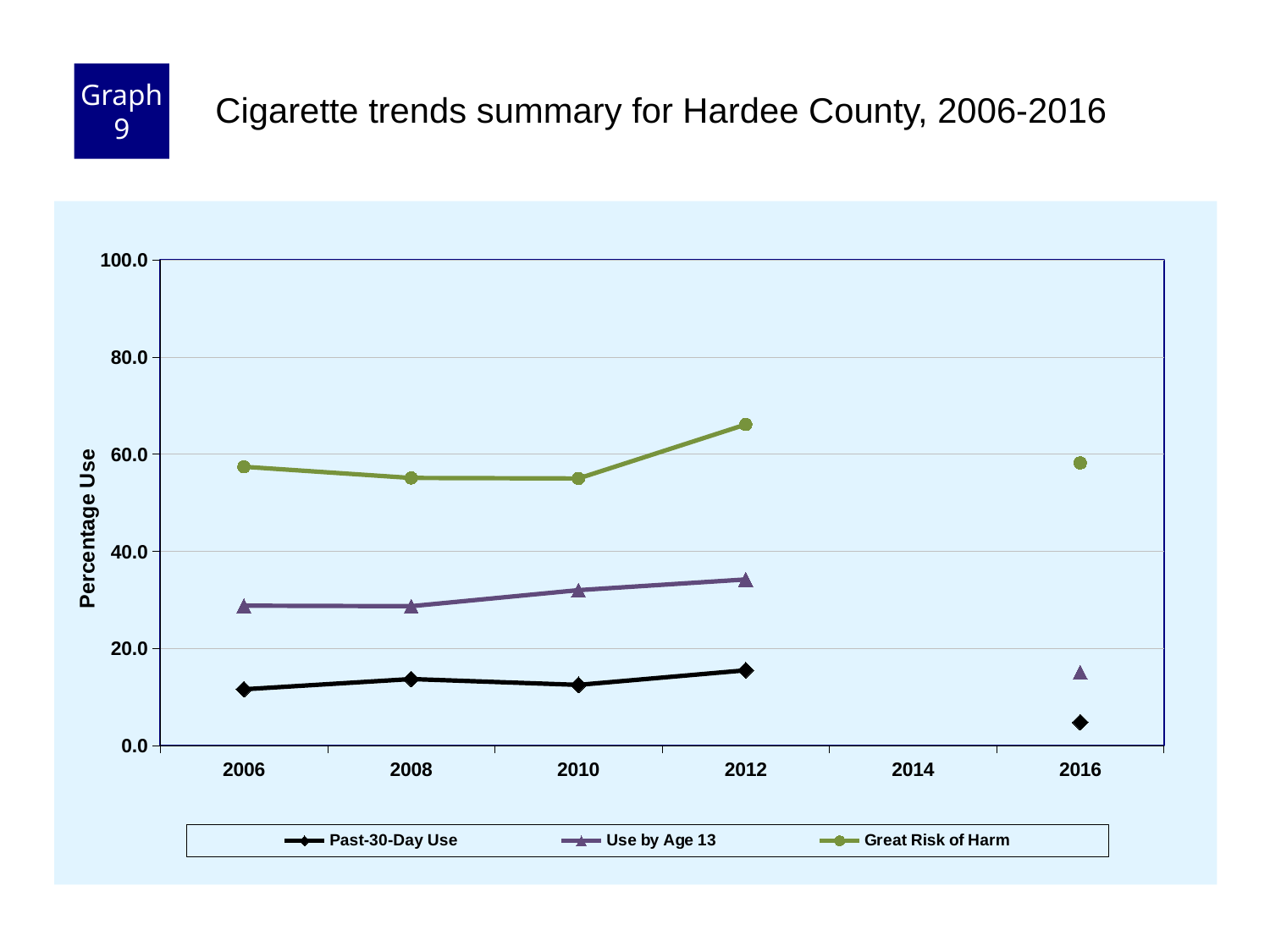
How many years are labeled on the x axis? 6 Which series has the highest value in 2016? Great Risk of Harm How many series does the legend list? 3 Is the value for Use by Age 13 in 2006 greater or less than 40? less What is the title of the y axis? Percentage Use Does Use by Age 13 rise or fall from 2006 to 2012? rise What kind of chart is shown on the slide? line chart Is the value for Great Risk of Harm in 2012 greater or less than 60? greater In which year is Great Risk of Harm at its highest? 2012 In which year is Past-30-Day Use at its lowest? 2016 Which is larger for Use by Age 13: the value in 2012 or the value in 2016? 2012 Is the value for Past-30-Day Use in 2016 greater or less than 20? less